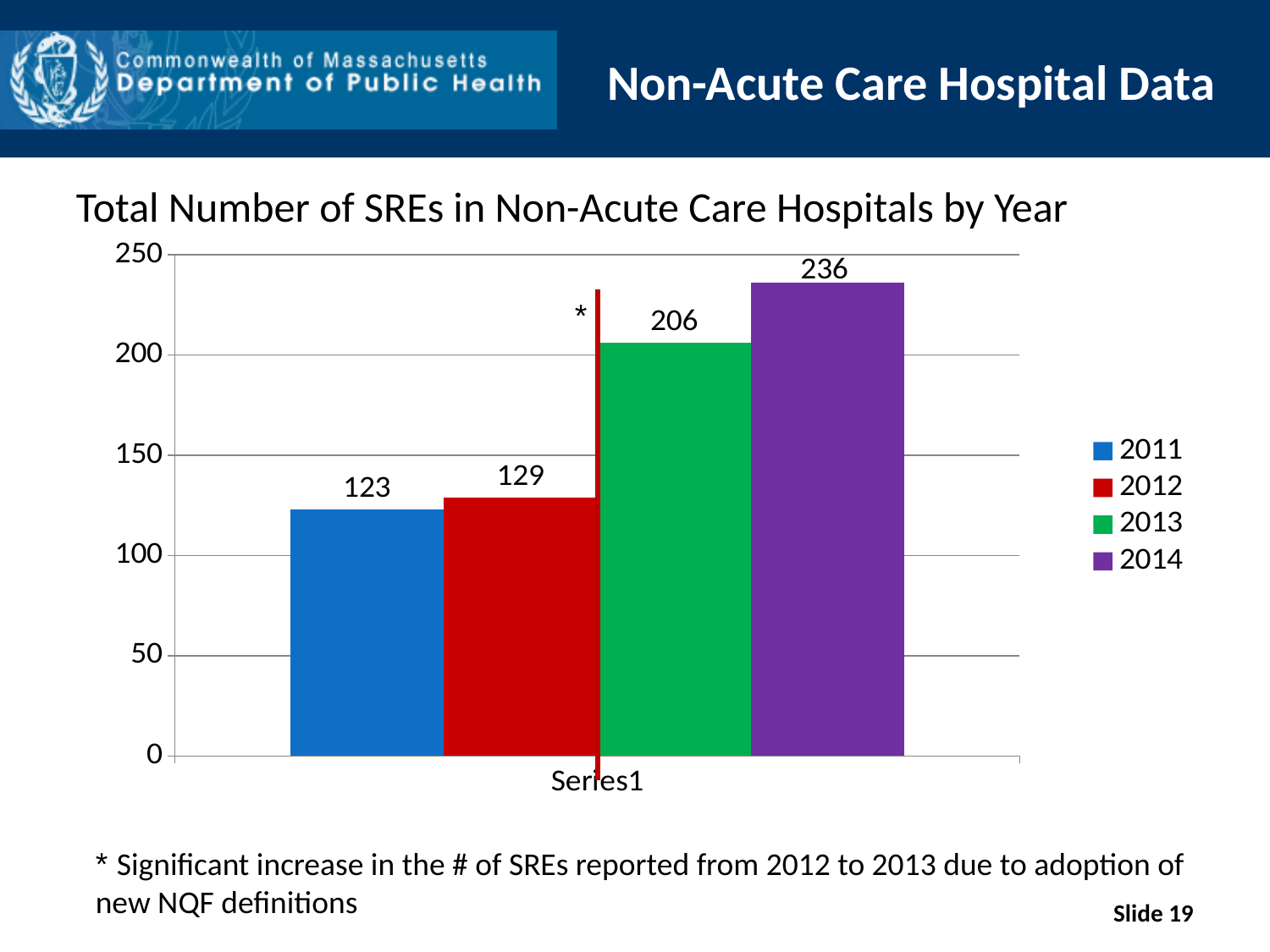
What is the total number of SREs in non-acute care hospitals for 2013? 206 What is the difference in the number of SREs between 2013 and 2012? 77 Which year had more SREs, 2012 or 2013? 2013 Is the value for 2012 greater or less than 150? less What is the total number of SREs in non-acute care hospitals for 2011? 123 What is the difference in the number of SREs between 2014 and 2011? 113 Which year has the lowest number of SREs? 2011 Do the number of SREs rise or fall from 2011 to 2014? rise Which year has the highest number of SREs? 2014 What kind of chart is shown on the slide? bar chart How many series does the legend list? 4 What is the total number of SREs in non-acute care hospitals for 2014? 236